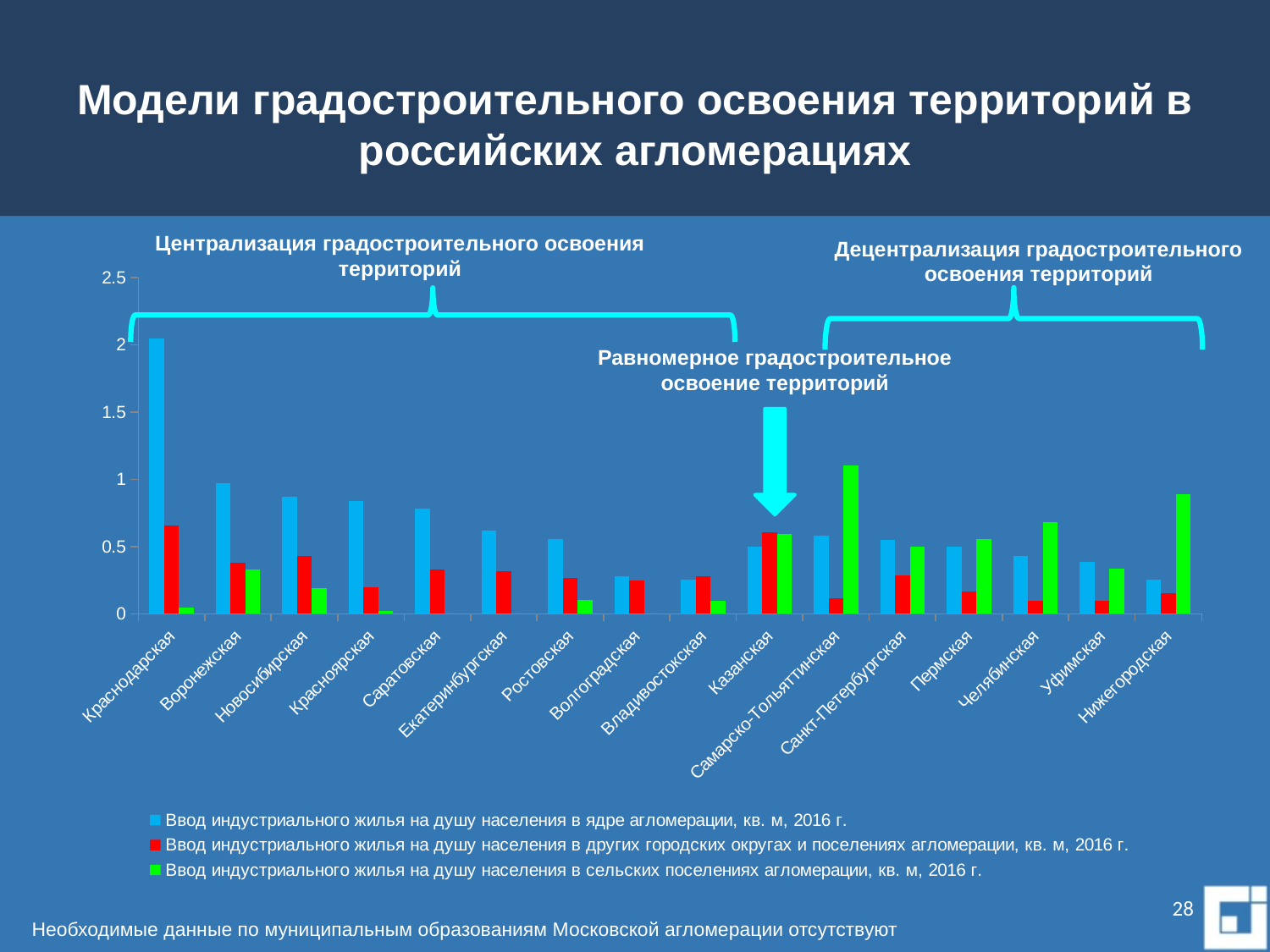
For Самарско-Тольяттинская, which is larger: the rural settlements (green) value or the other urban districts (red) value? rural settlements (green) Is the value for Самарско-Тольяттинская in rural settlements (green series) greater or less than 1? greater Which is larger: the agglomeration core (blue) value for Краснодарская or for Воронежская? Краснодарская How many series does the chart legend list? 3 Is the value for Санкт-Петербургская in other urban districts and settlements (red series) greater or less than 0.5? less Which agglomeration has the highest value for industrial housing per capita in the agglomeration core (blue series)? Краснодарская How many agglomerations (categories) are shown on the x axis of the chart? 16 Which agglomeration has the highest value for industrial housing per capita in rural settlements (green series)? Самарско-Тольяттинская Which colour represents industrial housing per capita in rural settlements of the agglomeration in the legend? green Do the agglomeration core (blue) values rise or fall from Краснодарская to Владивостокская along the x axis? fall What kind of chart is shown on the slide? bar chart Is the value for Краснодарская in the agglomeration core (blue series) greater or less than 1.5? greater